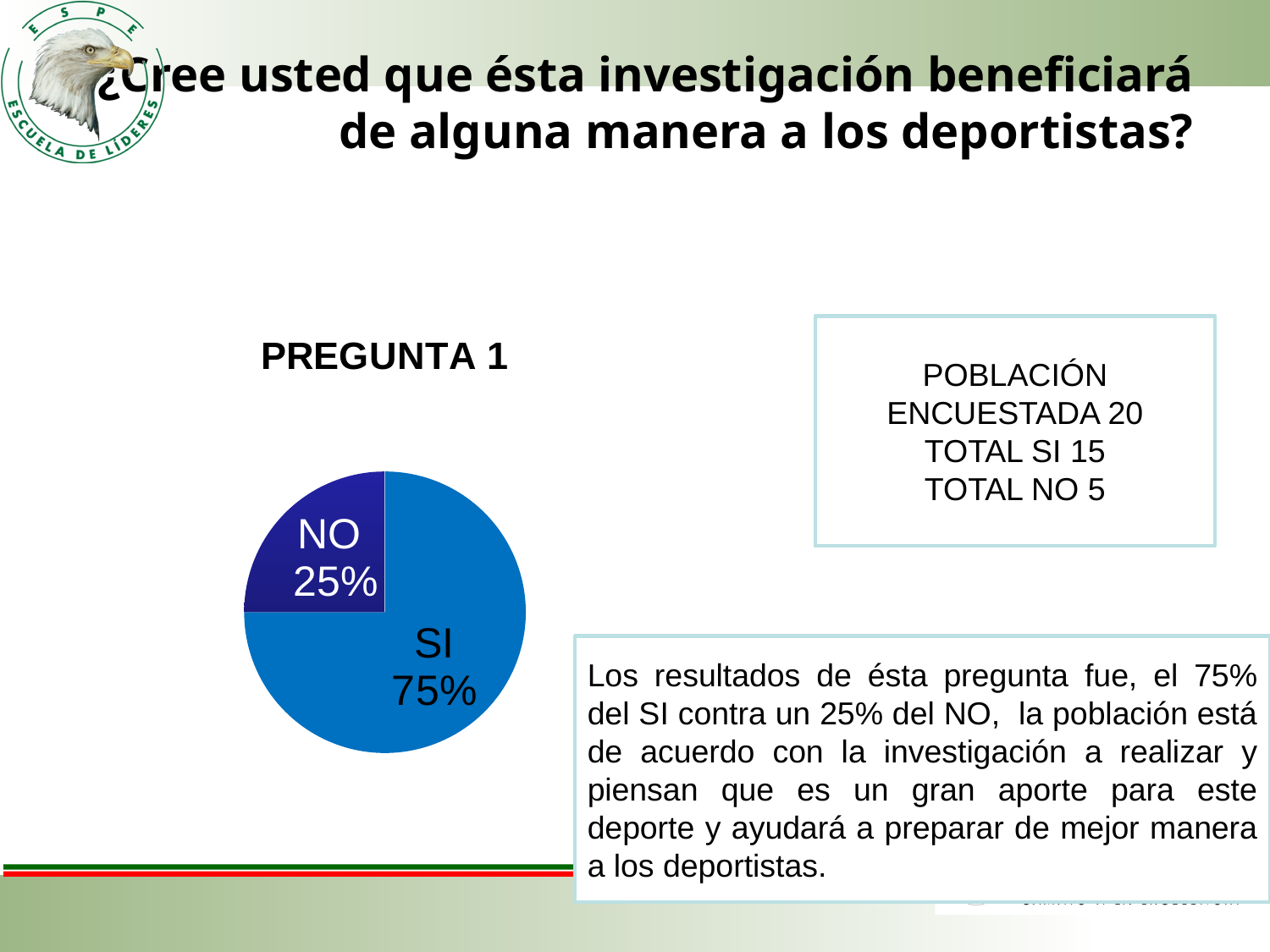
Is the value for NO greater or less than 50%? less What colour is the NO slice of the pie? dark blue Is the value for SI greater or less than 50%? greater What share of the pie does the NO slice represent? 25% What is the title of the chart? PREGUNTA 1 Which slice of the pie is the smallest? NO How many slices does the pie chart have? 2 What kind of chart is shown on the slide? pie chart Which is larger, the SI slice or the NO slice? SI What share of the pie does the SI slice represent? 75% What is the difference in percentage points between the SI and NO slices? 50% Which slice of the pie is the largest? SI